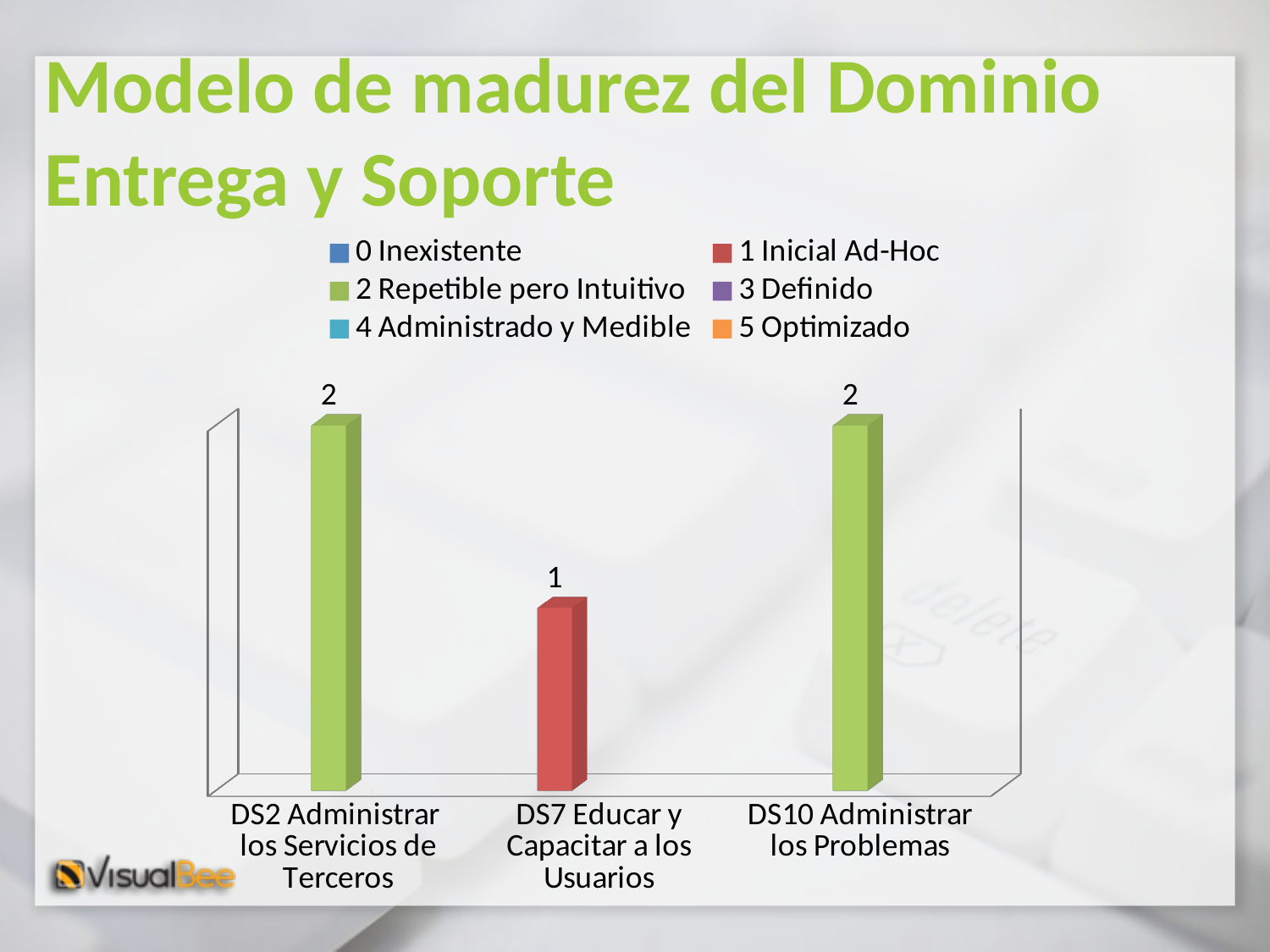
What kind of chart is shown on the slide? bar chart What is the difference between the values for DS2 Administrar los Servicios de Terceros and DS7 Educar y Capacitar a los Usuarios? 1 How many entries does the legend list? 6 Which legend entry corresponds to the red bar? 1 Inicial Ad-Hoc How many categories are shown on the x axis? 3 What is the value for DS10 Administrar los Problemas? 2 Which category has the lowest value? DS7 Educar y Capacitar a los Usuarios What is the value for DS7 Educar y Capacitar a los Usuarios? 1 What is the title of the slide? Modelo de madurez del Dominio Entrega y Soporte Which is larger, the value for DS10 Administrar los Problemas or the value for DS7 Educar y Capacitar a los Usuarios? DS10 Administrar los Problemas What is the value for DS2 Administrar los Servicios de Terceros? 2